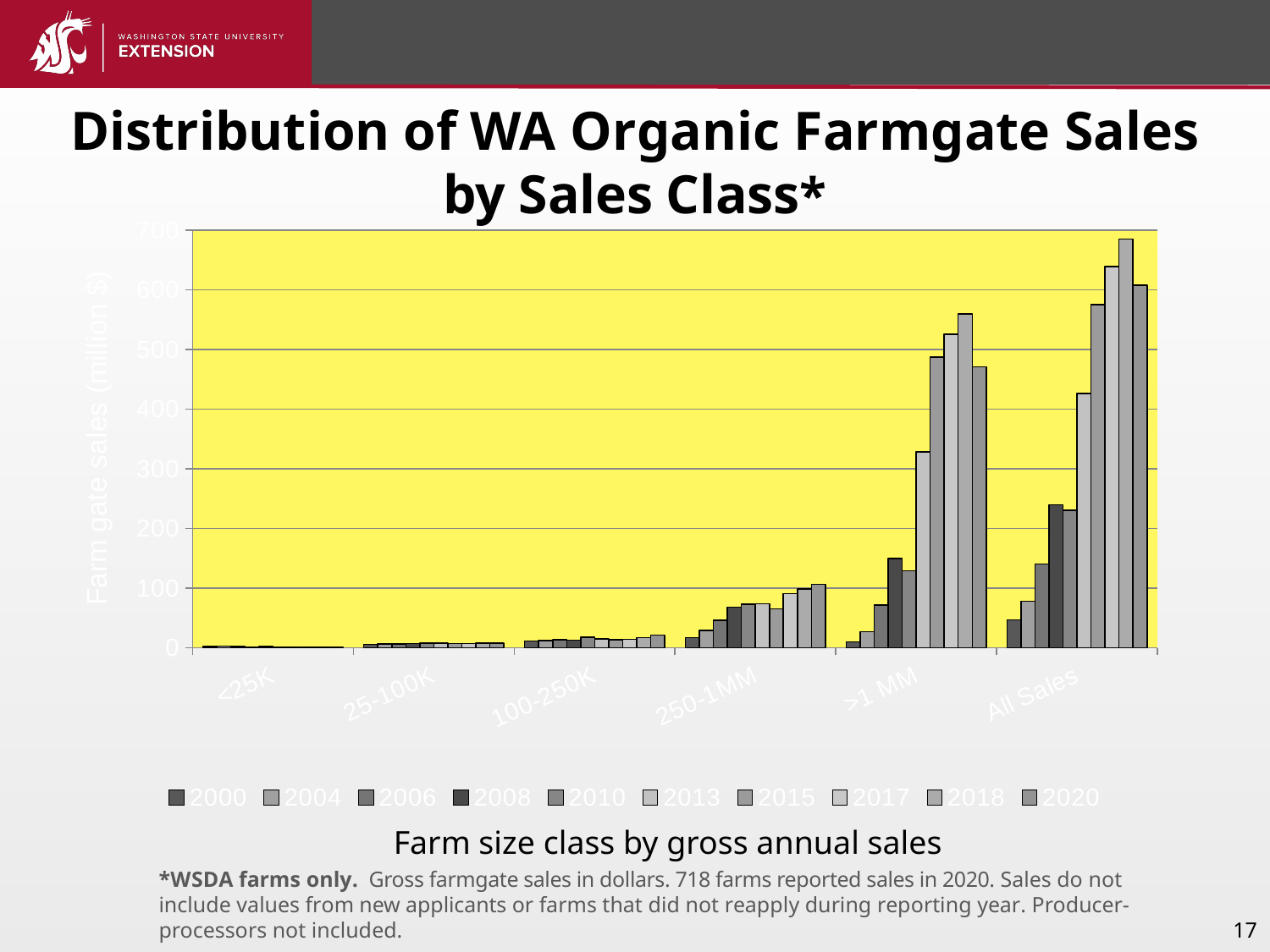
Which farm size class has the lowest bars? <25K How many farm size classes are shown on the x axis? 6 What kind of chart is shown on the slide? bar chart How many years does the legend list? 10 Is the value for 2018 in the All Sales class greater or less than 600? greater Are all the bars in the 250-1MM class greater or less than 200? less What is the label of the y axis? Farm gate sales (million $) Is the value for 2020 in the >1 MM class greater or less than 500? less Which farm size class has the tallest bars? All Sales For 2020, which class has the larger value: 250-1MM or >1 MM? >1 MM Do the bar heights generally rise or fall moving from <25K to All Sales along the x axis? rise